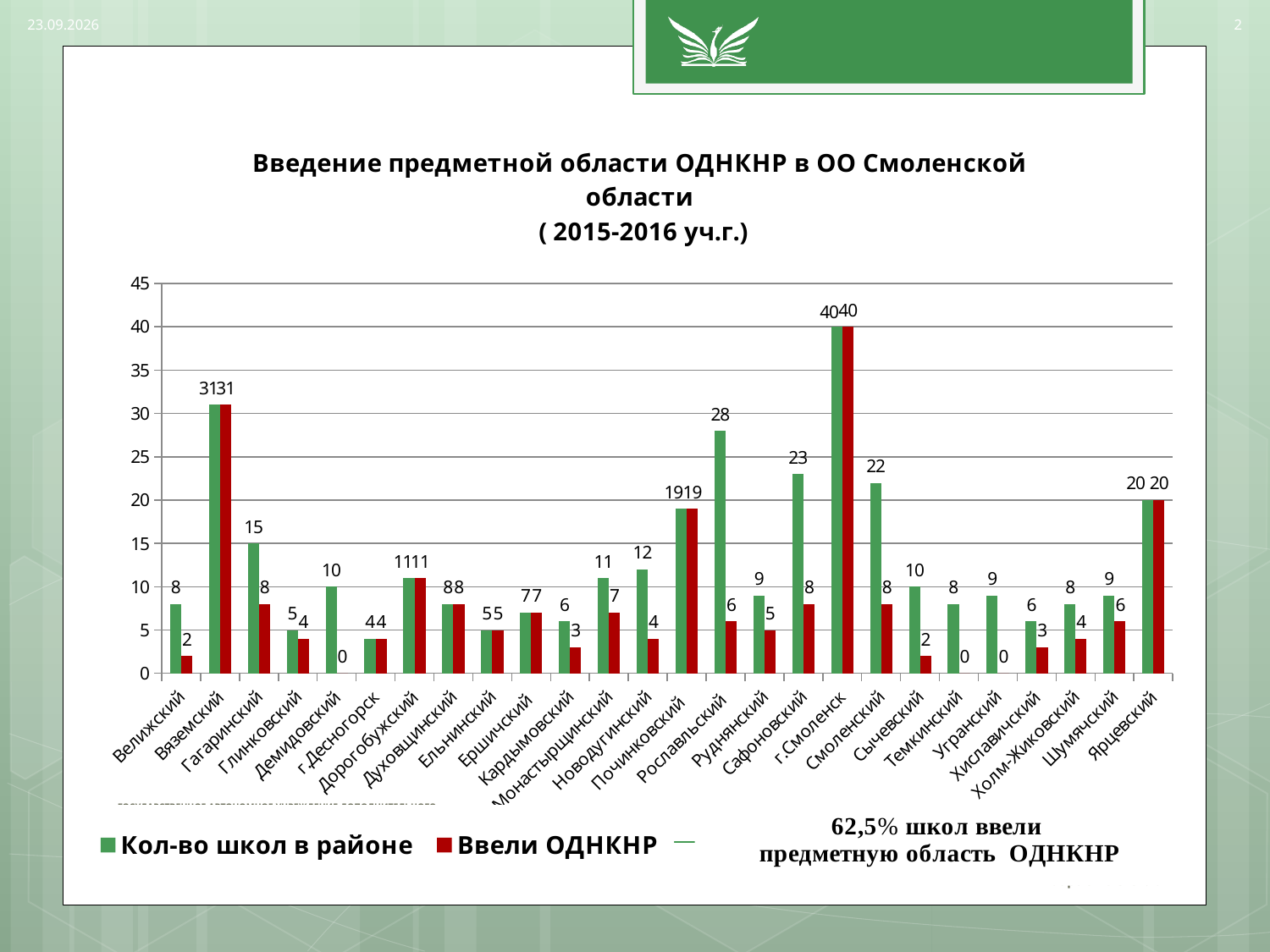
What type of chart is shown on the slide? bar chart What percentage of schools introduced the ОДНКНР subject area, according to the text next to the legend? 62,5% What is the value of 'Ввели ОДНКНР' for Демидовский? 0 What is the value of 'Ввели ОДНКНР' for Сафоновский? 8 How many districts (categories) are shown on the x axis? 26 What is the difference between 'Кол-во школ в районе' and 'Ввели ОДНКНР' for Новодугинский? 8 What is the value of 'Кол-во школ в районе' for Рославльский? 28 Is the value of 'Кол-во школ в районе' for Починковский greater or less than 15? greater What is the difference between 'Кол-во школ в районе' and 'Ввели ОДНКНР' for Смоленский? 14 How many series does the legend list? 2 Which district has the highest value for 'Кол-во школ в районе'? г.Смоленск Which is larger: 'Кол-во школ в районе' for Вяземский or for Сафоновский? Вяземский